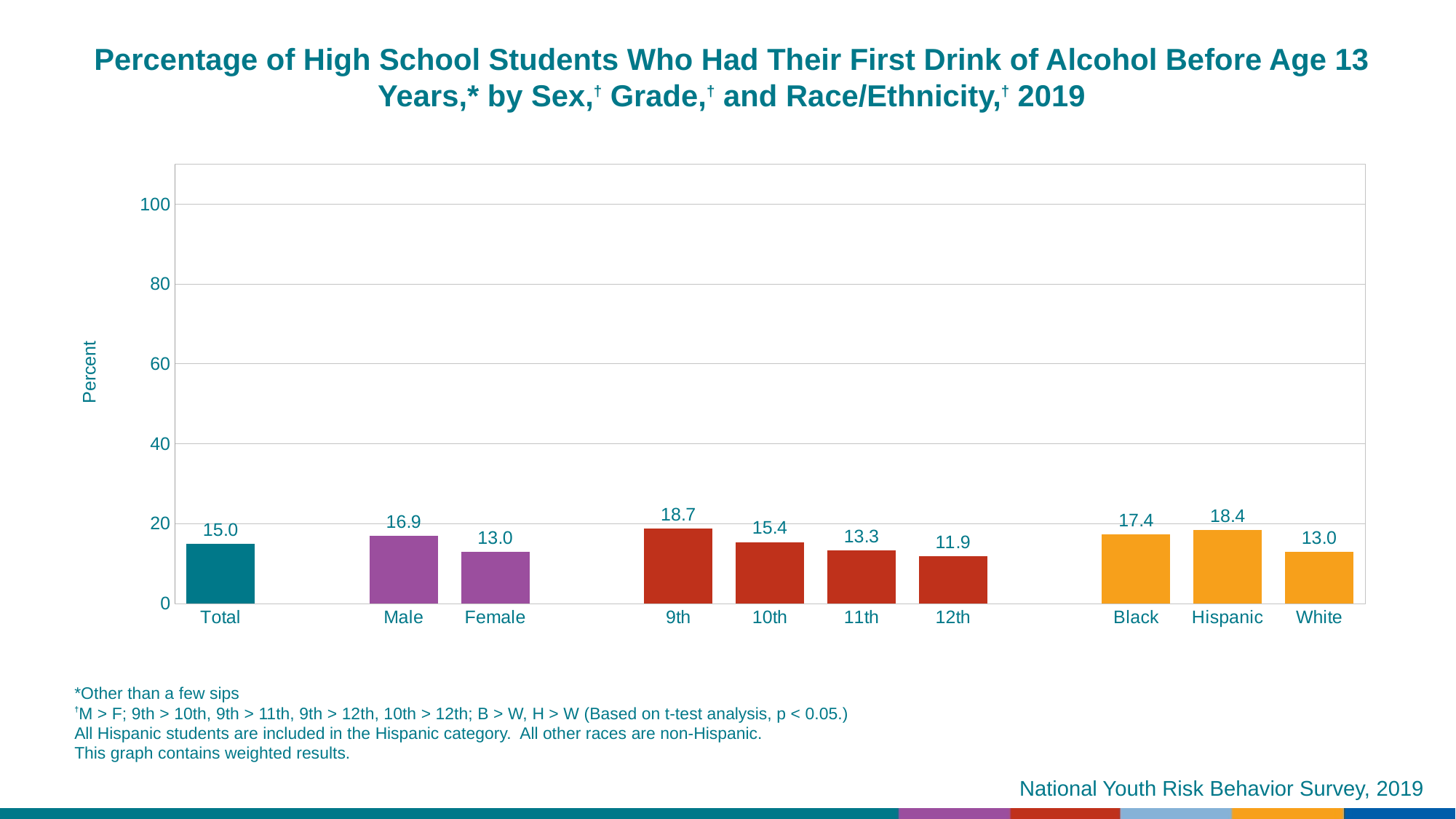
What is the value for Hispanic? 18.4 Which category has the lowest value? 12th What kind of chart is this? bar chart How many categories are shown on the x axis? 10 Which category has the highest value? 9th What is the difference between the Male and Female values? 3.9 Do the values rise or fall from 9th grade to 12th grade? fall What is the value for Total? 15.0 Is the value for 10th grade greater or less than 20? less What is the value for Male? 16.9 What is the value for 12th grade? 11.9 Which is larger, the value for Black or the value for White? Black